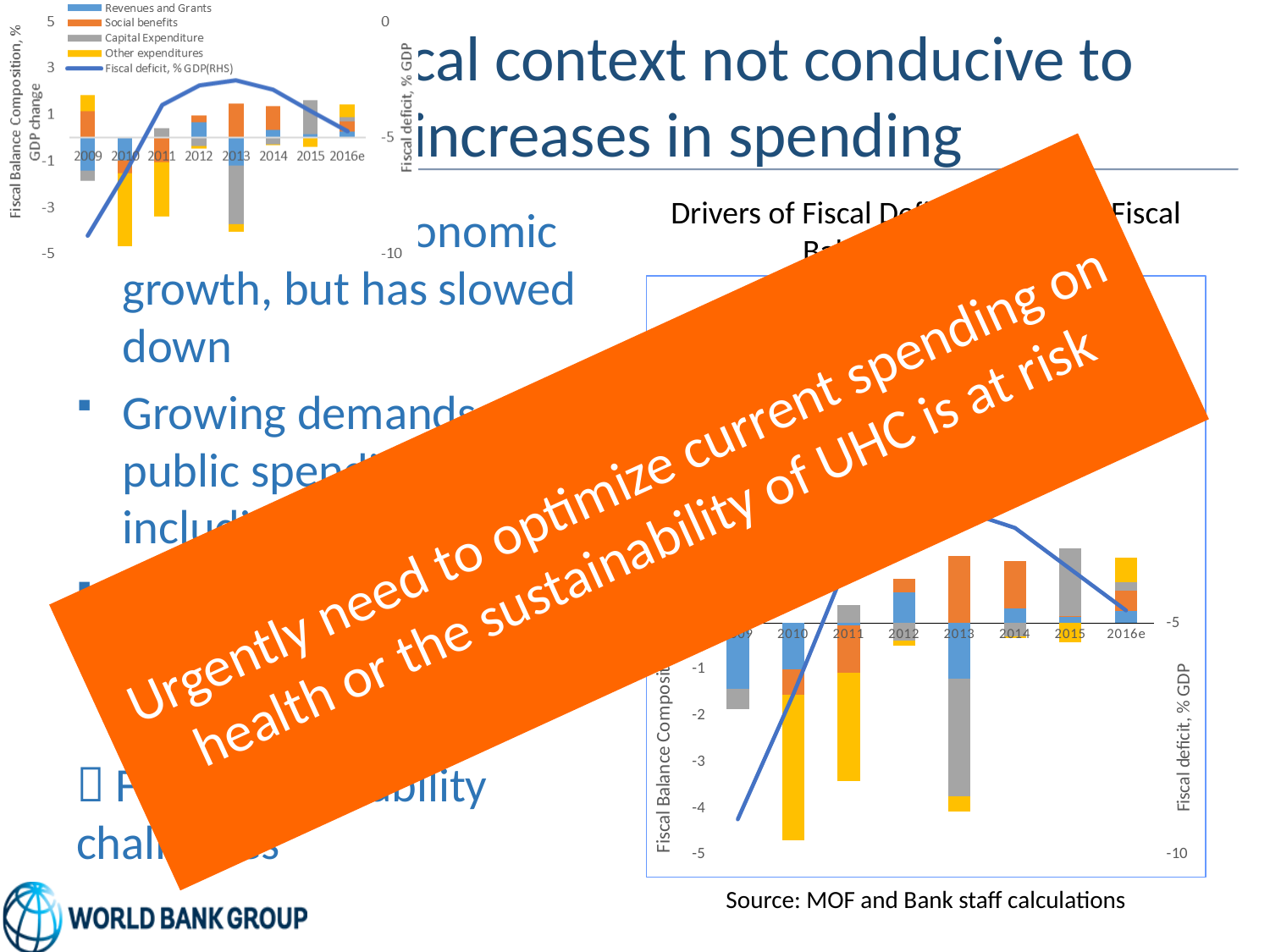
In the bottom-right chart, is the lowest point of the 2012 stacked bar greater or less than -1? greater What is the label of the right-hand vertical axis of the bottom-right chart? Fiscal deficit, % GDP How many years (categories) are shown on the x axis of the bottom-right chart? 8 How many series does the legend of the top-left chart list? 5 In the bottom-right chart, is the lowest point of the 2011 stacked bar greater or less than -3? less In the top-left chart, what colour represents Social benefits? Orange What kind of chart is shown at the bottom right of the slide? A stacked bar chart with a line In the top-left chart, which series is plotted as a line? Fiscal deficit, % GDP(RHS) In the top-left chart, does the fiscal deficit line rise or fall from 2009 to 2011? Rises In the bottom-right chart, is the lowest point of the 2010 stacked bar greater or less than -4? less In the bottom-right chart, does the fiscal deficit line rise or fall from 2013 to 2016e? Falls In the top-left chart, which year's stacked bar extends furthest below zero? 2010